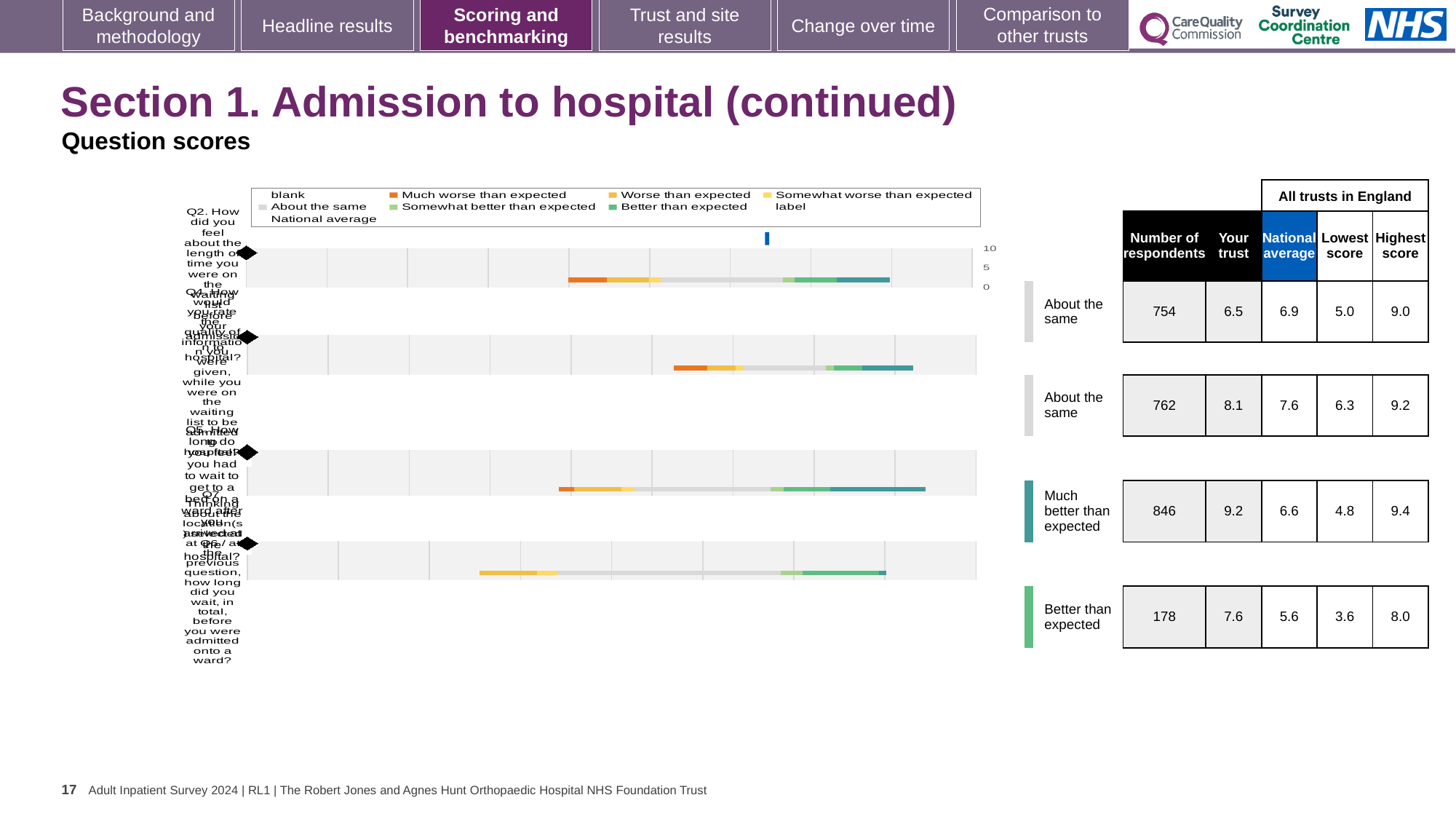
How many question rows are plotted in the chart? 4 Which row has the lowest number of respondents? Better than expected (178 respondents) What kind of chart is shown on the slide? bar chart What is the 'Your trust' score for the first row (rated 'About the same', 754 respondents)? 6.5 For the first row (754 respondents), is the 'Your trust' score or the national average larger? National average What is the difference between the 'Your trust' score and the national average for the row rated 'Much better than expected'? 2.6 What is the national average for the second row (rated 'About the same', 762 respondents)? 7.6 Which row has the highest 'Your trust' score? Much better than expected (846 respondents) What is the maximum value shown on the chart's score axis? 10 What is the 'Your trust' score for the row rated 'Much better than expected'? 9.2 How many respondents are there for the row rated 'Better than expected'? 178 What is the highest score across all trusts in England for the row rated 'Better than expected'? 8.0